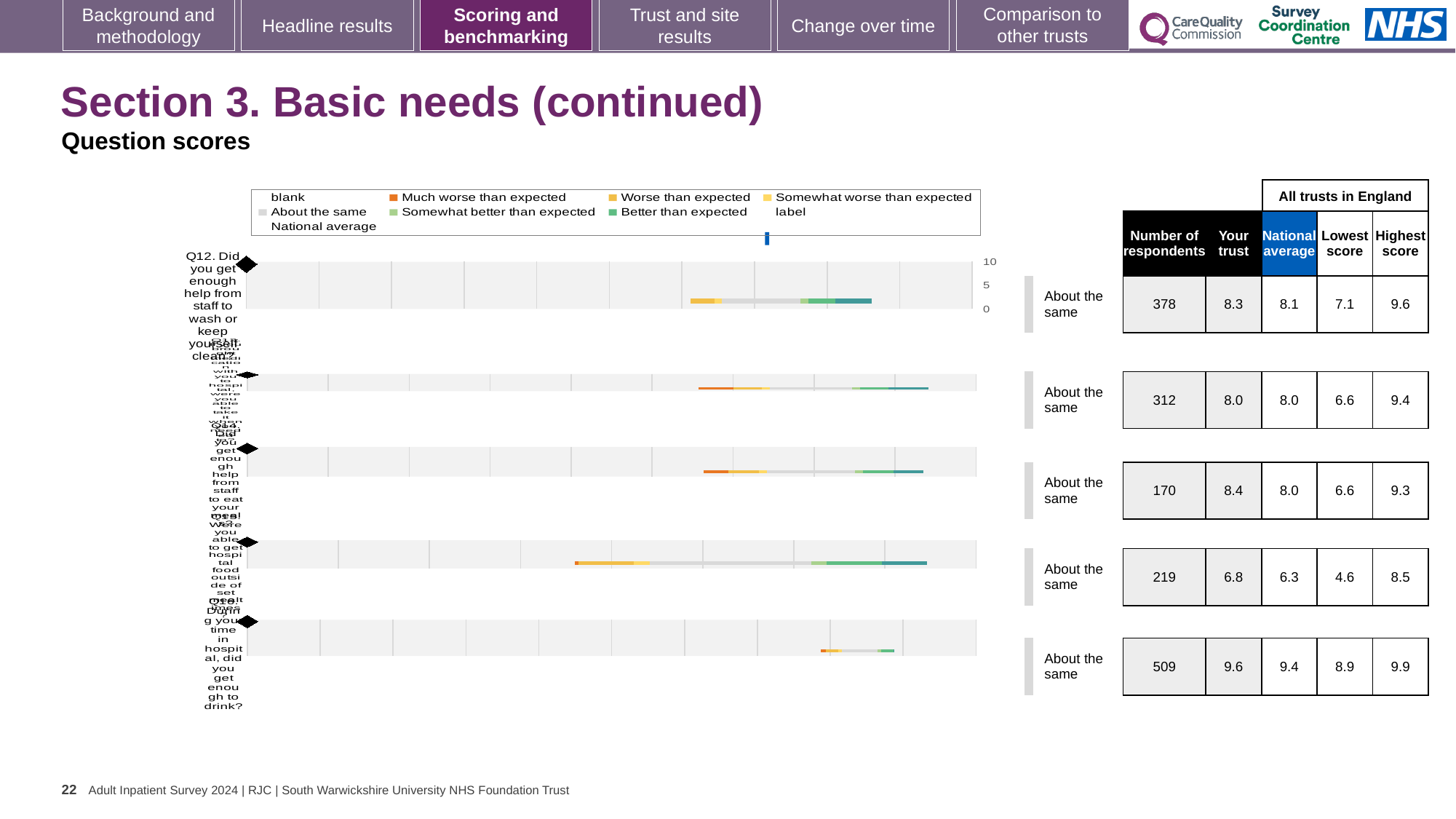
How many question rows (bars) are plotted in the chart? 5 What is the highest score across all trusts in England for the fourth question row? 8.5 What benchmark category is shown next to each of the five question rows? About the same What is the national average for Q12 (help from staff to wash or keep yourself clean)? 8.1 Which question row has the highest 'Your trust' score? The last row (did you get enough to drink?), 9.6 Which question row has the lowest 'Your trust' score? The fourth row, 6.8 By how much does the 'Your trust' score for Q12 exceed the national average? 0.2 For Q12, which is larger: the 'Your trust' score or the national average? Your trust What kind of chart is shown on the slide? bar chart What is the number of respondents for Q12 (help from staff to wash or keep yourself clean)? 378 What is the 'Your trust' score for Q12 (help from staff to wash or keep yourself clean)? 8.3 What is the lowest score across all trusts in England for the last row (did you get enough to drink?)? 8.9